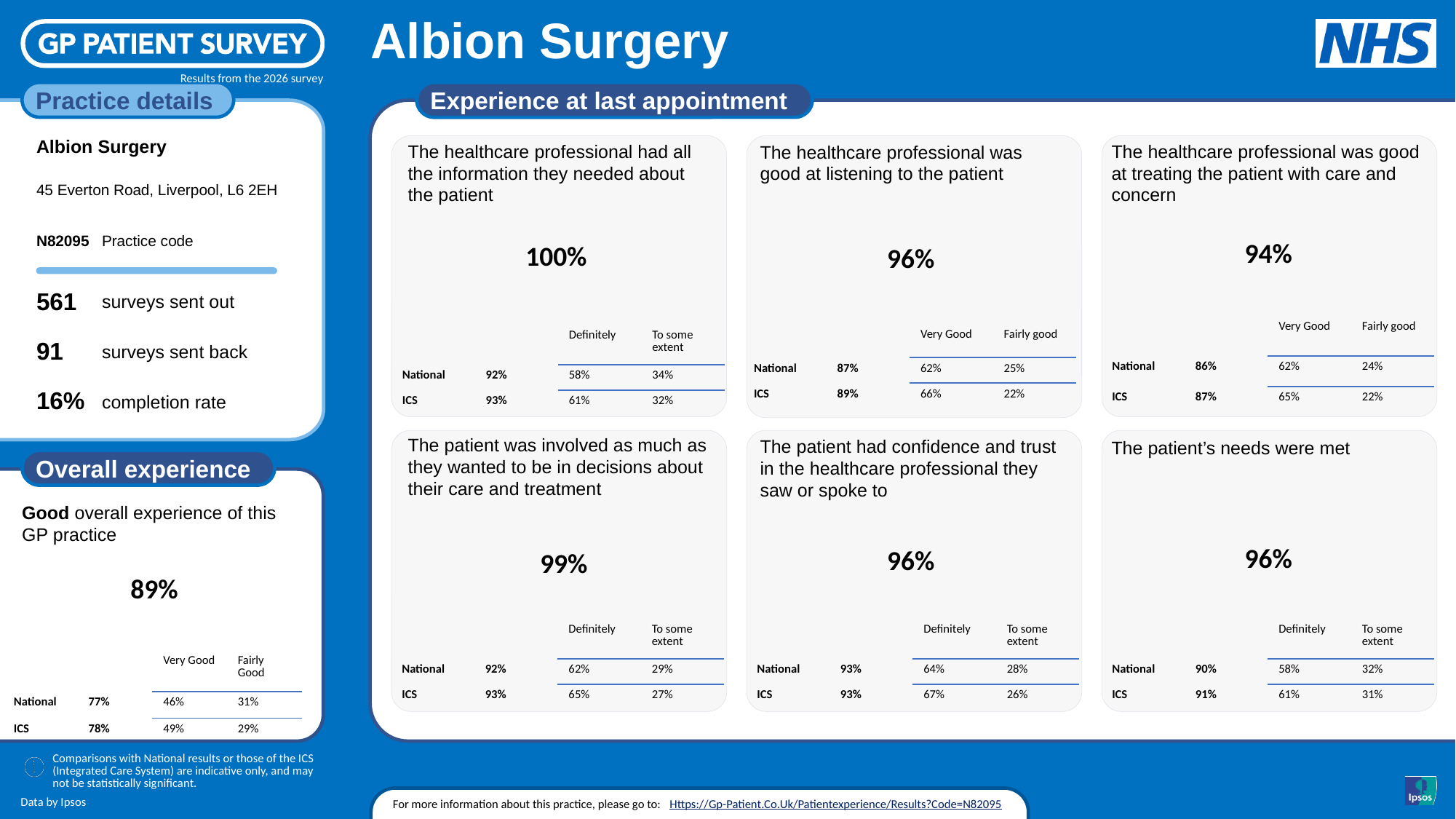
In the Overall experience panel, what percentage of patients reported a good overall experience of this GP practice? 89% In the Overall experience panel, what is the National figure for good overall experience? 77% In the Experience at last appointment section, which measure has the lowest practice value? The healthcare professional was good at treating the patient with care and concern In the Experience at last appointment section, what is the practice's value for 'The patient was involved as much as they wanted to be in decisions about their care and treatment'? 99% In the Overall experience panel, what is the ICS figure for good overall experience? 78% In the Experience at last appointment section, what is the practice's value for 'The healthcare professional had all the information they needed about the patient'? 100% In the 'The patient's needs were met' panel, what is the National figure? 90% In the Overall experience panel, what is the National 'Very Good' percentage? 46% How many measures are shown in the Experience at last appointment section? 6 In the Experience at last appointment section, what is the practice's value for 'The healthcare professional was good at treating the patient with care and concern'? 94% In the Overall experience panel, what is the difference between the practice's 89% and the National 77%? 12 percentage points In the Experience at last appointment section, which measure has the highest practice value? The healthcare professional had all the information they needed about the patient